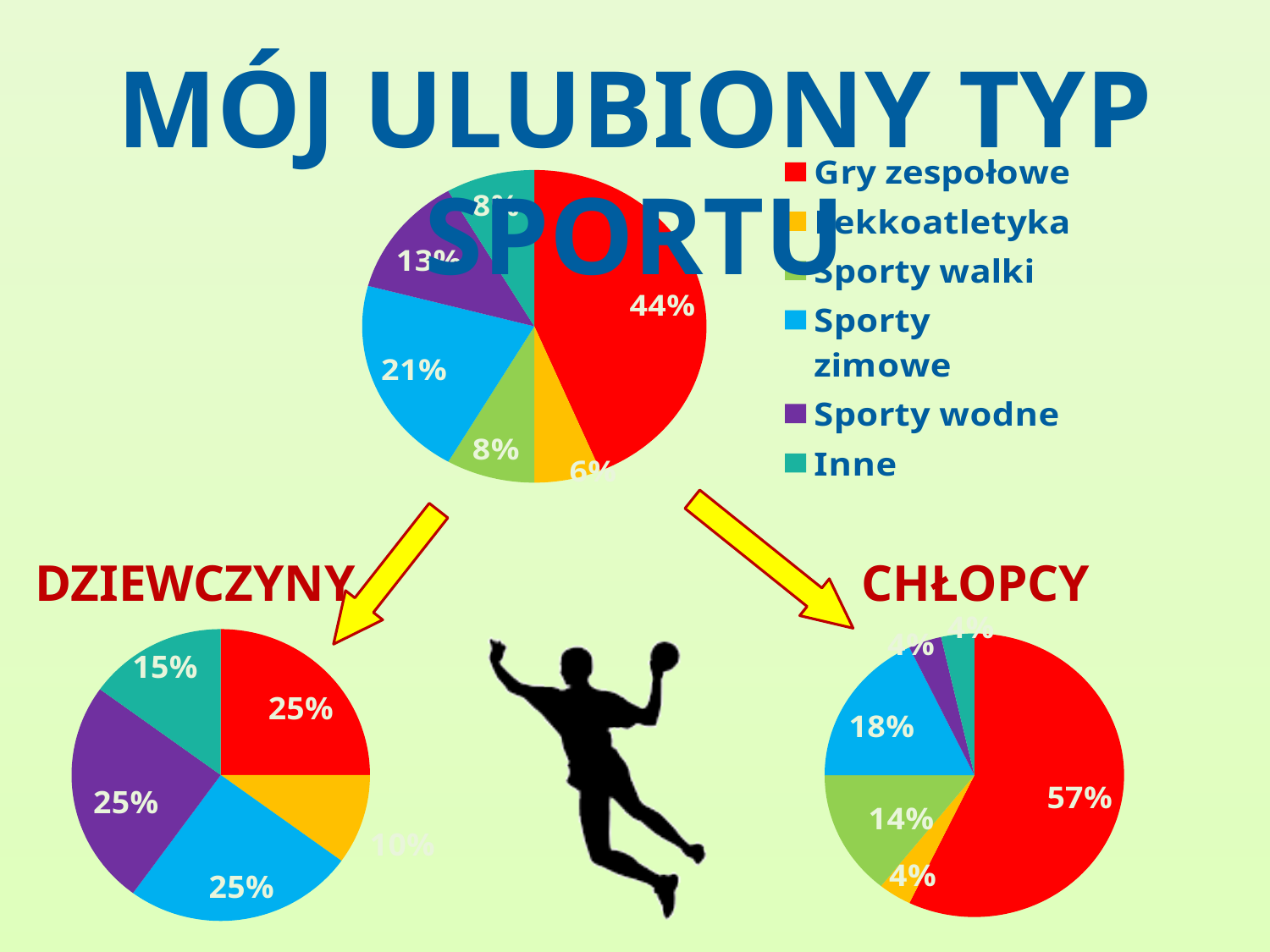
How many percentage points higher is Gry zespołowe in the CHŁOPCY chart than in the DZIEWCZYNY chart? 32 percentage points In the top pie chart, what percentage is shown for Lekkoatletyka? 6% In the top pie chart, which category has the largest slice? Gry zespołowe In the CHŁOPCY pie chart, what percentage is shown for Sporty walki? 14% How many categories does the legend list? 6 In the DZIEWCZYNY pie chart, what percentage is shown for Inne? 15% In the top pie chart, what percentage is shown for Gry zespołowe? 44% In the DZIEWCZYNY pie chart, which category has the smallest slice? Lekkoatletyka In the top pie chart, what percentage is shown for Sporty zimowe? 21% In the top pie chart, which is larger: Sporty zimowe or Sporty wodne? Sporty zimowe In the CHŁOPCY pie chart, what percentage is shown for Gry zespołowe? 57% In the CHŁOPCY pie chart, what percentage is shown for Sporty zimowe? 18%